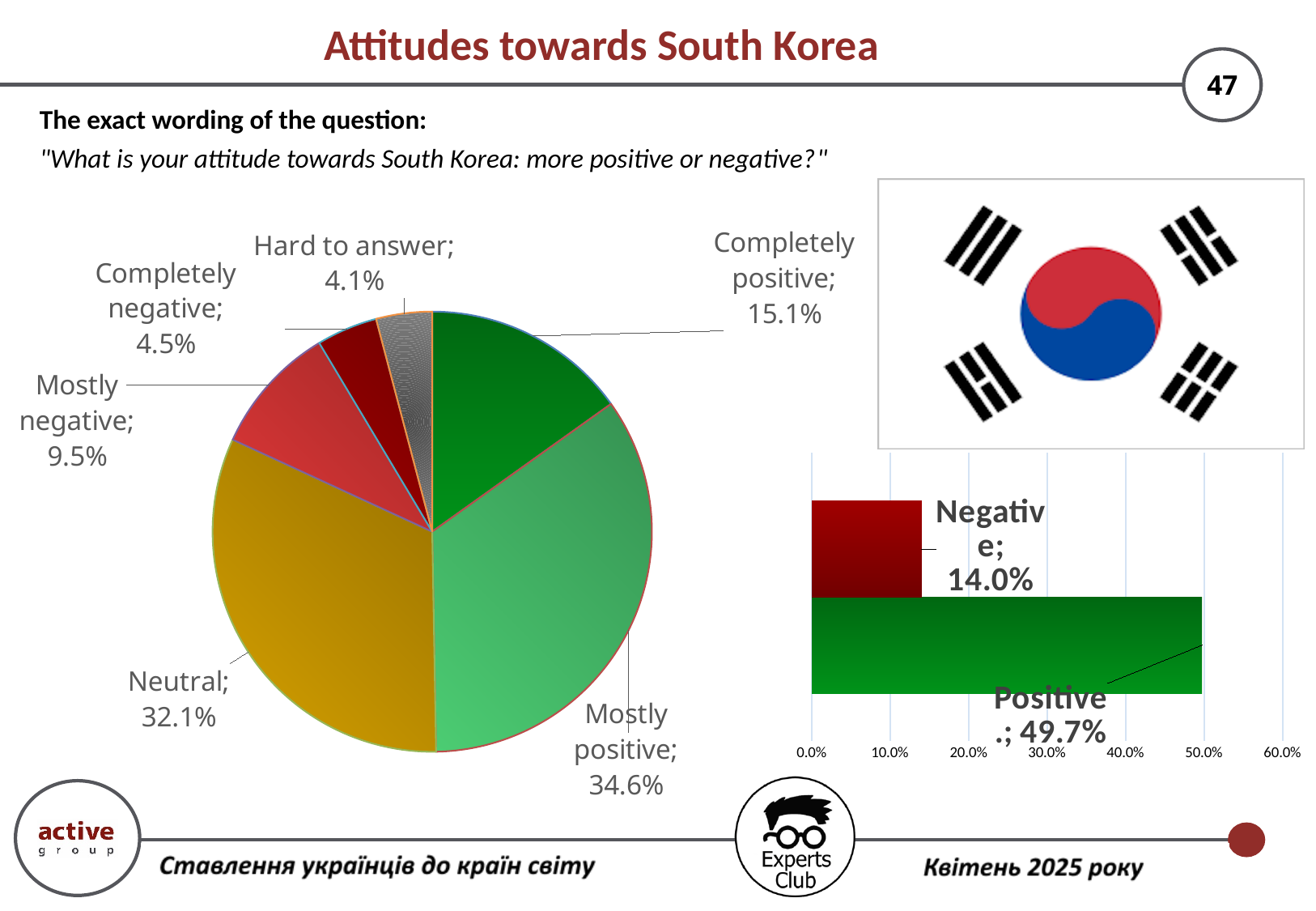
In the pie chart, which category has the smallest share? Hard to answer In the bar chart on the right, what is the value for 'Positive'? 49.7% What kind of chart is shown on the right side of the slide below the flag? Bar chart In the pie chart, what is the difference between 'Completely positive' and 'Mostly negative'? 5.6% In the pie chart, what share of respondents answered 'Completely negative'? 4.5% In the pie chart, which category has the largest share? Mostly positive In the pie chart, how many categories are shown? 6 In the bar chart on the right, what is the value for 'Negative'? 14.0% In the pie chart, what share of respondents answered 'Neutral'? 32.1% In the pie chart, which is larger: 'Mostly negative' or 'Hard to answer'? Mostly negative In the pie chart, what share of respondents answered 'Mostly positive'? 34.6% In the bar chart on the right, what is the difference between 'Positive' and 'Negative'? 35.7%